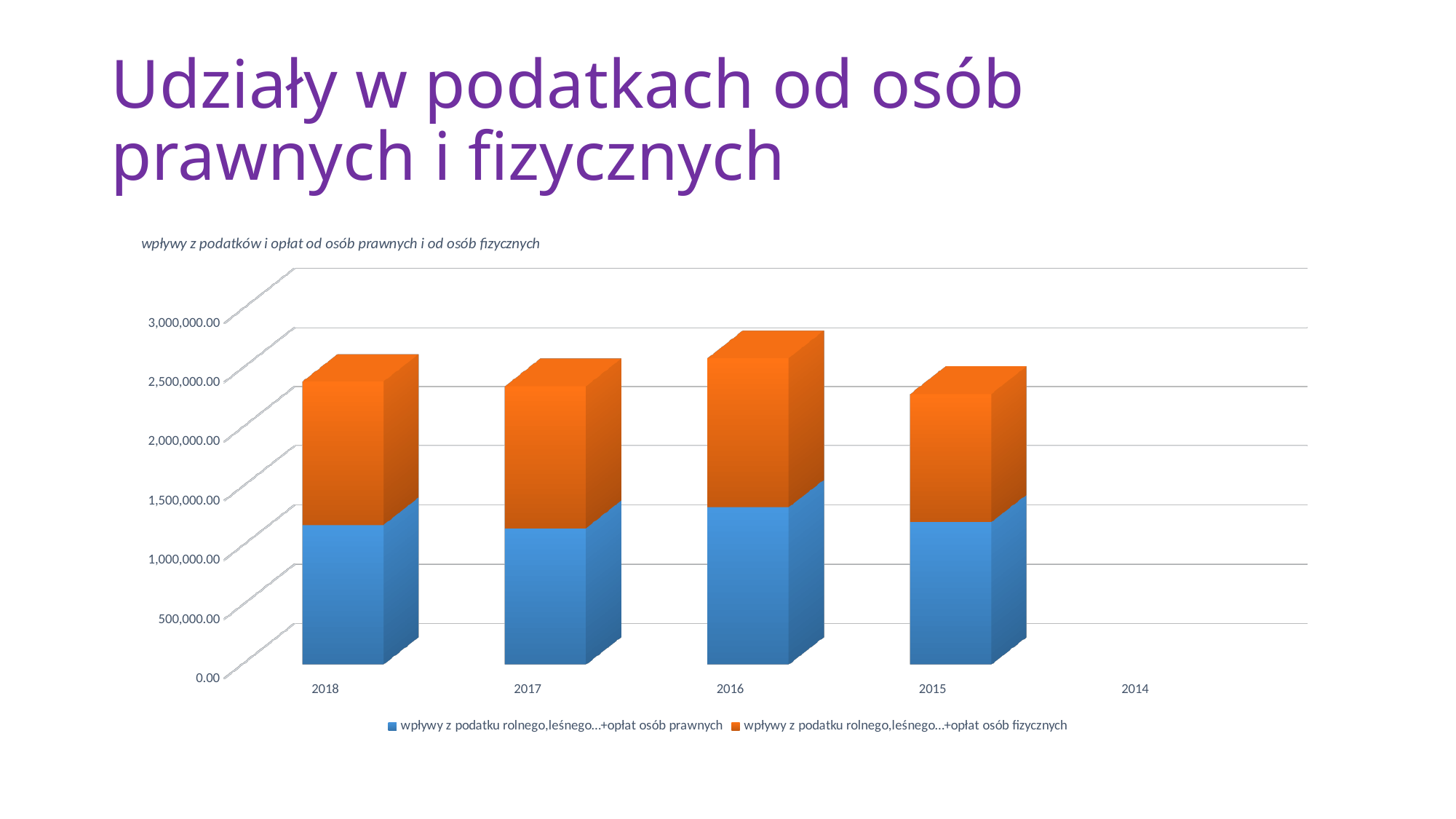
Among the years with bars, which year has the lowest total? 2015 Which year has the larger total stacked value, 2016 or 2015? 2016 Is the total stacked value for 2015 greater or less than 2,500,000.00? less What kind of chart is shown on the slide? stacked bar chart How many year labels are shown on the x axis? 5 Which year has the tallest stacked bar in total? 2016 What is the title printed above the chart? wpływy z podatków i opłat od osób prawnych i od osób fizycznych Is the total stacked value for 2016 greater or less than 2,500,000.00? greater Is the value of the 'osób prawnych' (blue) series for 2018 greater or less than 1,000,000.00? greater How many series does the legend list? 2 How many years have a bar plotted in the chart? 4